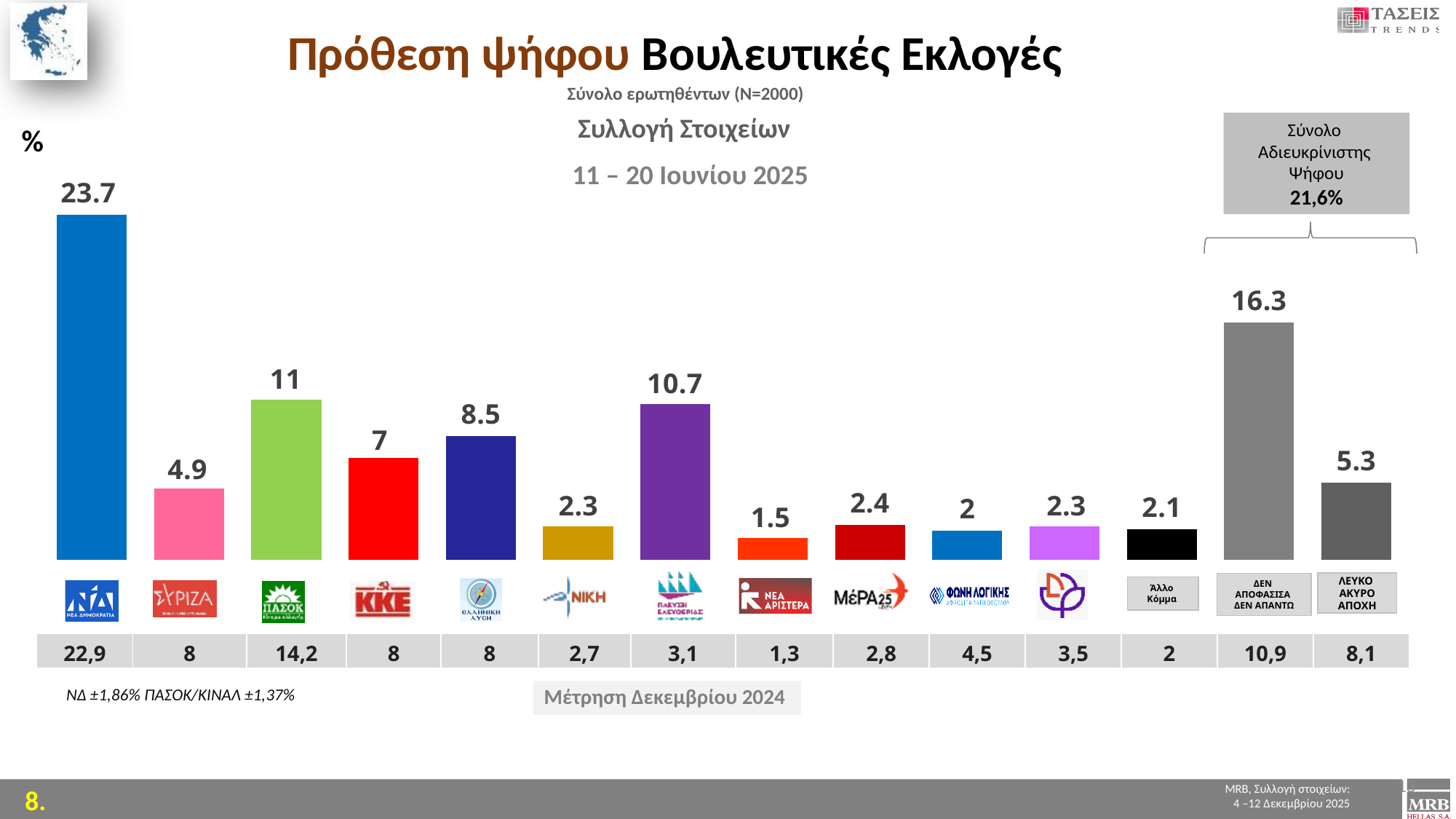
What kind of chart is shown on the slide? Bar chart What is the value for the 'ΔΕΝ ΑΠΟΦΑΣΙΣΑ ΔΕΝ ΑΠΑΝΤΩ' bar? 16.3 Which is larger, the value for ΣΥΡΙΖΑ or the value for Ελληνική Λύση? Ελληνική Λύση Which category has the lowest value in the chart? Νέα Αριστερά What is the difference between the values for ΝΔ and ΠΑΣΟΚ? 12.7 What is the value for ΚΚΕ in the chart? 7 What is the value for ΠΑΣΟΚ in the chart? 11 Which party has the highest value in the chart? ΝΔ (Νέα Δημοκρατία) What is the value for ΝΔ (Νέα Δημοκρατία) in the chart? 23.7 How many bars are shown in the chart? 14 What is the total undecided vote ('Σύνολο Αδιευκρίνιστης Ψήφου') shown in the box on the slide? 21,6% What is the value for Πλεύση Ελευθερίας in the chart? 10.7